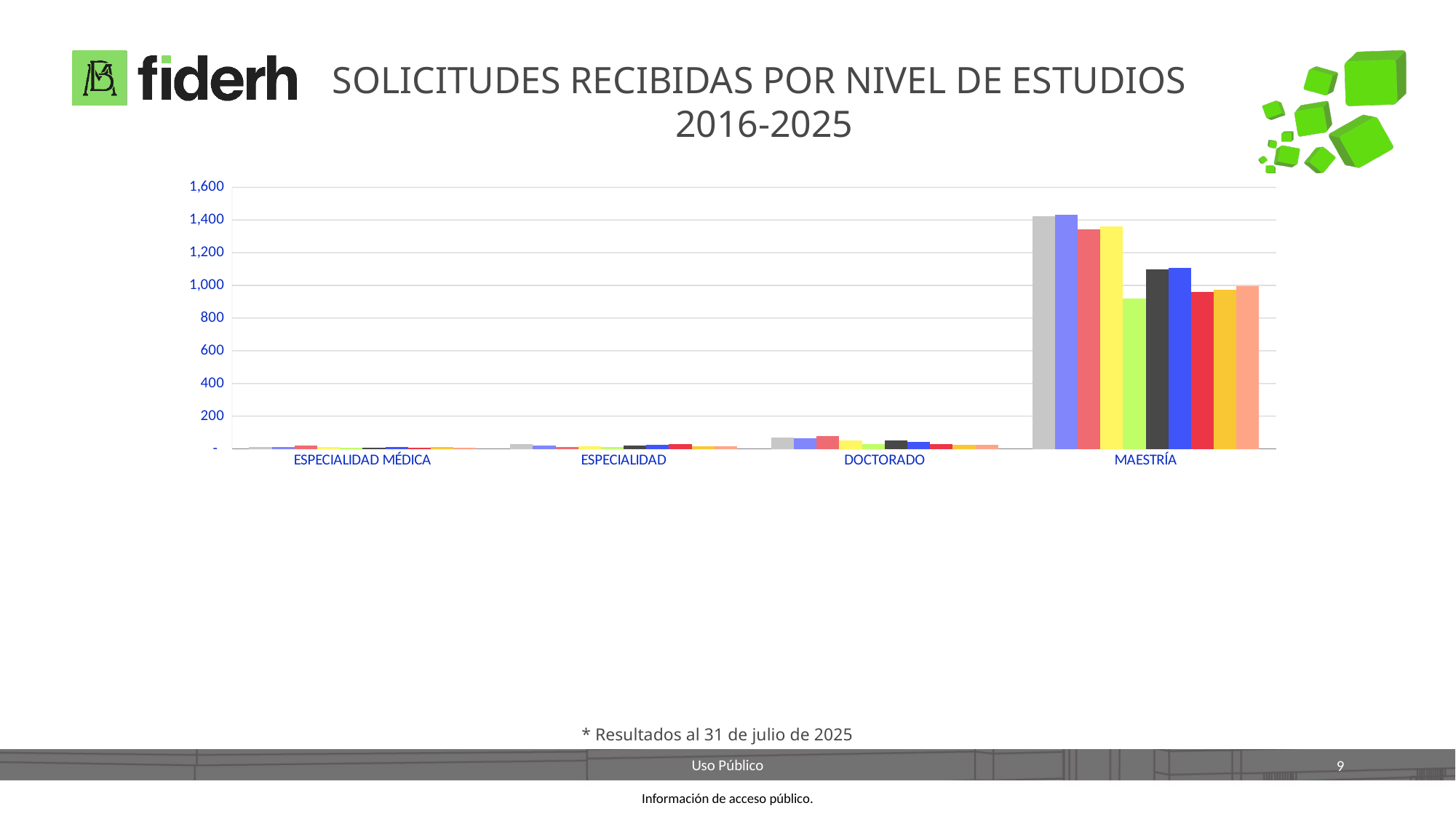
What is the highest value shown on the y axis? 1,600 Which category has taller bars, MAESTRÍA or DOCTORADO? MAESTRÍA What is the title of the chart on the slide? SOLICITUDES RECIBIDAS POR NIVEL DE ESTUDIOS 2016-2025 How many study-level categories are shown on the x axis? 4 How many bars are plotted for each category? 10 Which category has the highest bars? MAESTRÍA Which category has taller bars, DOCTORADO or ESPECIALIDAD? DOCTORADO Which category has the lowest bars? ESPECIALIDAD MÉDICA What kind of chart is shown on the slide? bar chart Is the tallest bar for MAESTRÍA greater or less than 1,600? less Are the bars for DOCTORADO greater or less than 200? less Are the bars for MAESTRÍA greater or less than 800? greater